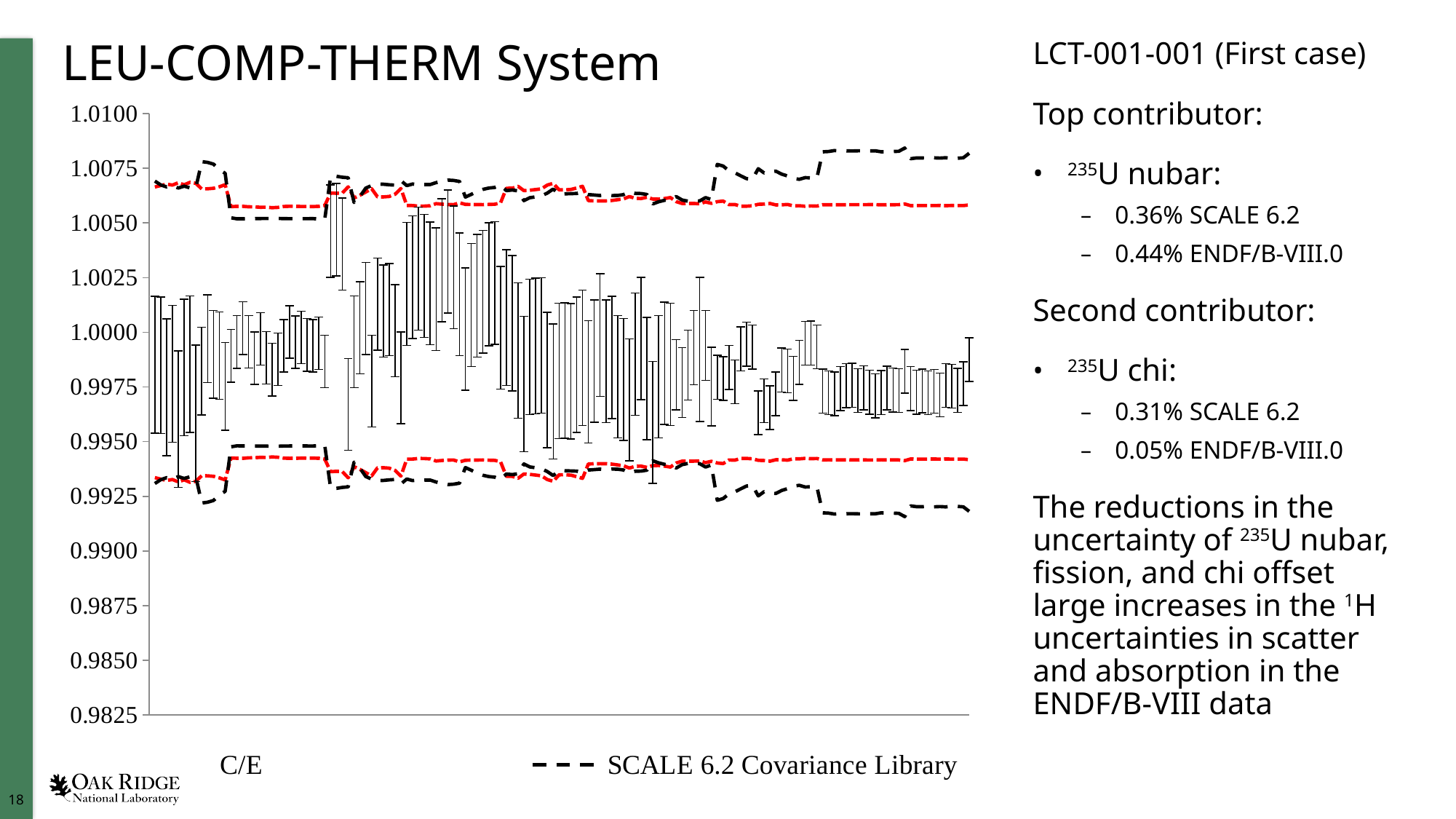
What is the title of the slide containing the chart? LEU-COMP-THERM System How many entries does the chart legend list? 2 What is the name of the dashed-line series in the chart legend? SCALE 6.2 Covariance Library What is the lowest value shown on the chart's y axis? 0.9825 Does the lower black dashed SCALE 6.2 Covariance Library line end higher or lower on the right side of the chart than it starts on the left? lower At the right end of the chart, is the lower red dashed line greater or less than 0.9925? greater At the right end of the chart, is the lower black dashed SCALE 6.2 Covariance Library line greater or less than 0.9925? less At the right end of the chart, is the upper black dashed SCALE 6.2 Covariance Library line greater or less than 1.0075? greater Does the upper black dashed SCALE 6.2 Covariance Library line end higher or lower on the right side of the chart than it starts on the left? higher